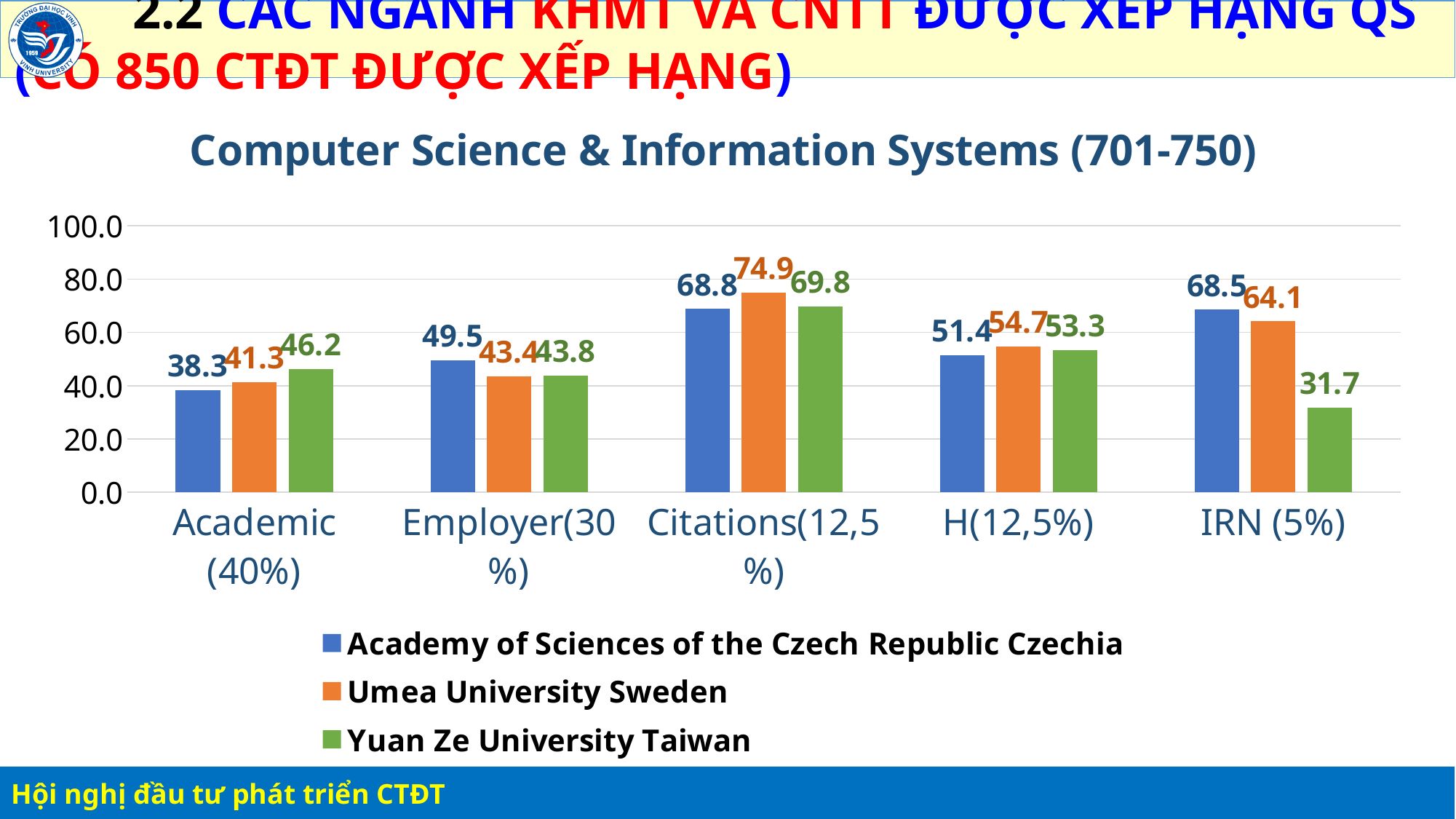
How many series does the legend list? 3 In the Academic (40%) category, which series has the larger value: Umea University Sweden or Yuan Ze University Taiwan? Yuan Ze University Taiwan In which category does Yuan Ze University Taiwan have its highest value? Citations(12,5%) What is the value for Yuan Ze University Taiwan in the IRN (5%) category? 31.7 What kind of chart is shown on the slide? Bar chart What is the difference between the Academy of Sciences of the Czech Republic Czechia and Yuan Ze University Taiwan values in the IRN (5%) category? 36.8 How many categories are shown on the x axis? 5 What is the value for Umea University Sweden in the Citations(12,5%) category? 74.9 In which category does Academy of Sciences of the Czech Republic Czechia have its lowest value? Academic (40%) What is the value for Academy of Sciences of the Czech Republic Czechia in the Employer(30%) category? 49.5 Is the value for Umea University Sweden in the H(12,5%) category greater or less than 60.0? less What is the title of the chart? Computer Science & Information Systems (701-750)